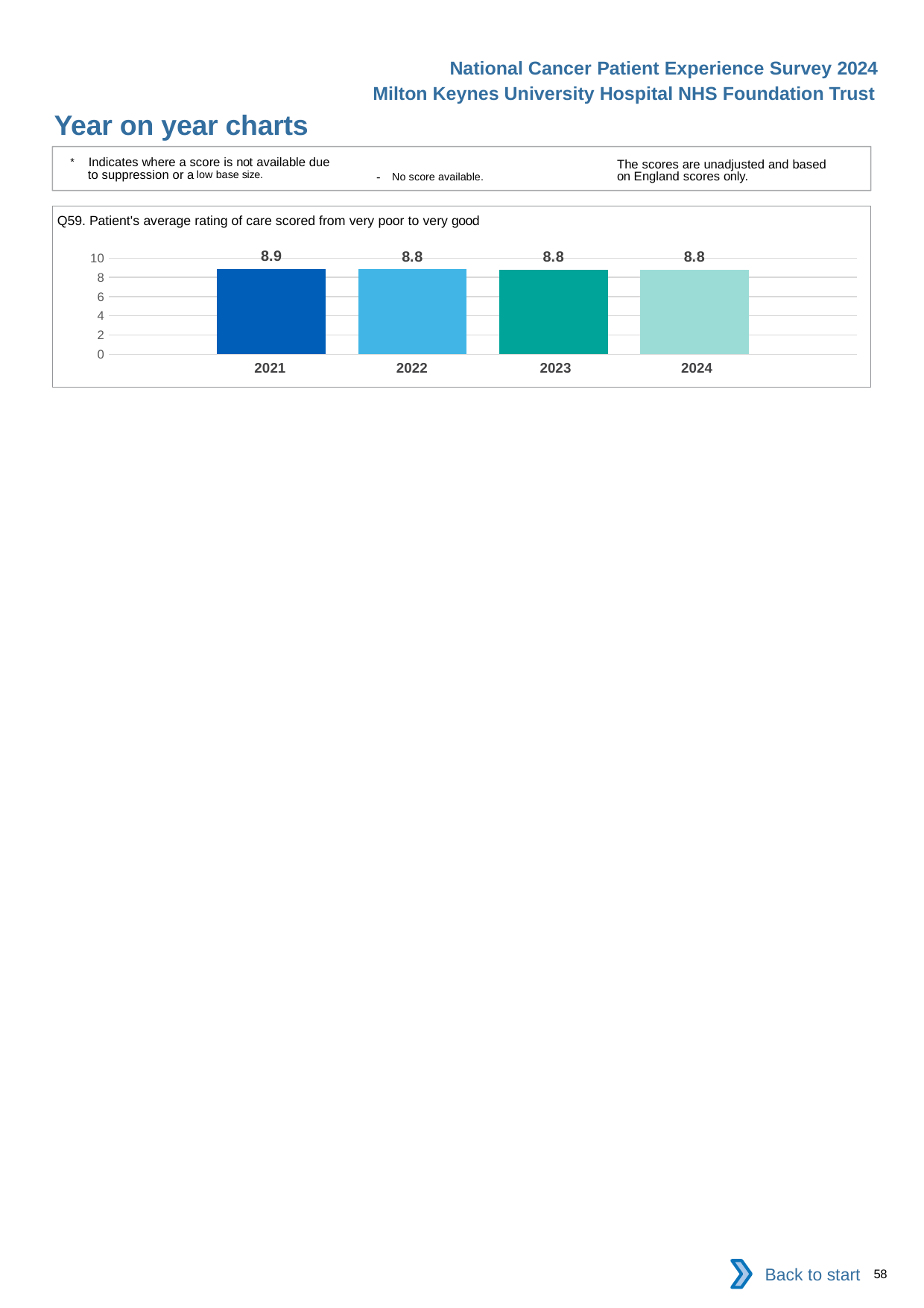
What is the value for 2021? 8.9 Do the values rise or fall from 2021 to 2022? fall Is the value for 2023 greater or less than 6? greater Which is larger, the value for 2021 or the value for 2022? 2021 What is the maximum value shown on the y axis? 10 What kind of chart is shown? bar chart What is the value for 2024? 8.8 What is the title of the chart? Q59. Patient's average rating of care scored from very poor to very good What is the value for 2022? 8.8 Which year has the highest value? 2021 What is the difference between the values for 2021 and 2023? 0.1 How many years are shown on the chart? 4